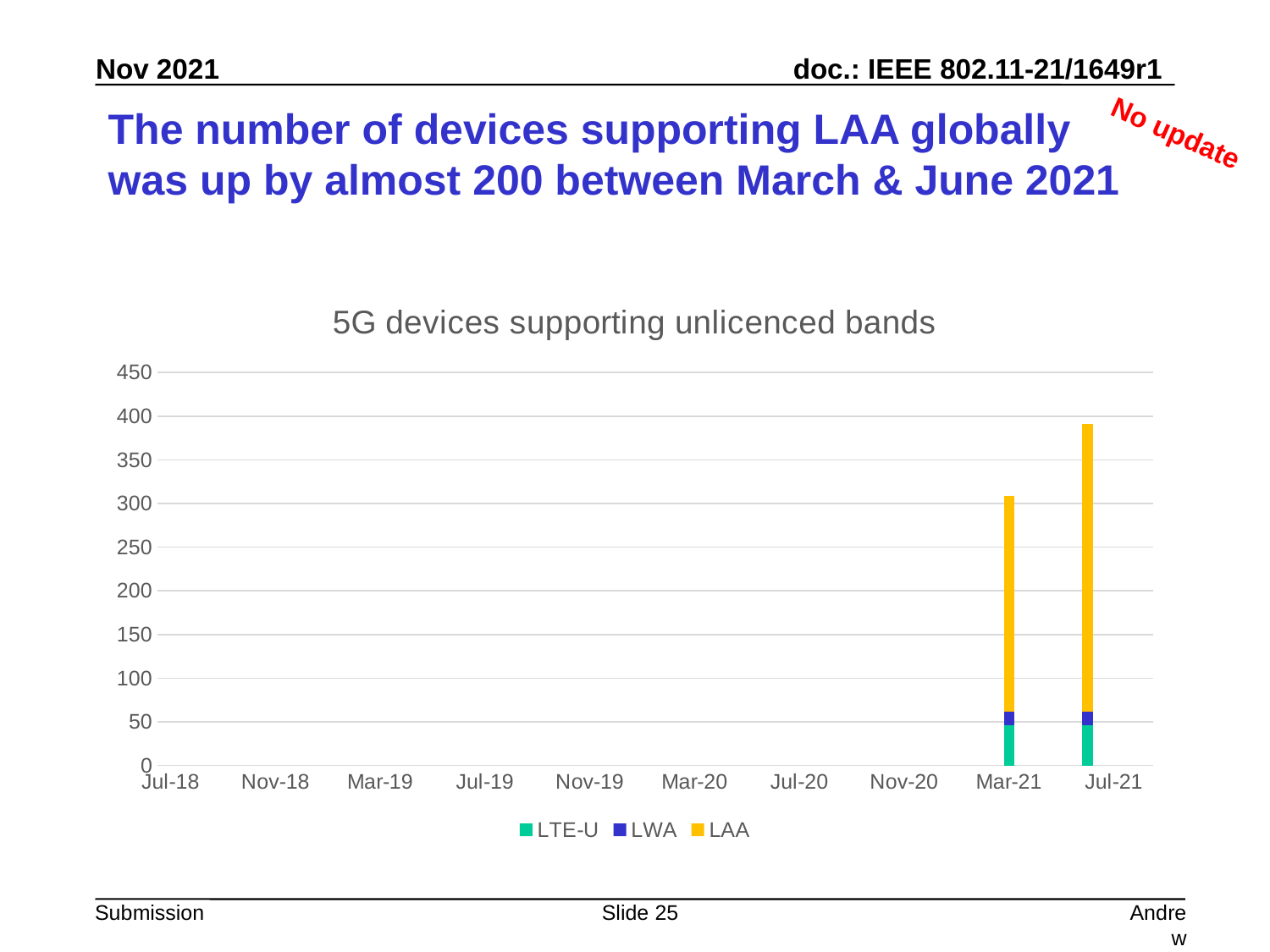
In the Jul-21 bar, which segment is larger, LAA or LTE-U? LAA How many category labels are shown along the x axis of the chart? 10 Is the total stacked value for Mar-21 greater or less than 250? greater What is the title of the chart? 5G devices supporting unlicenced bands What kind of chart is shown on the slide? bar chart Is the total stacked value for Jul-21 greater or less than 350? greater Which series is shown in yellow in the chart? LAA How many series does the legend of the chart list? 3 Is the total stacked value for Jul-21 greater or less than 400? less Which x-axis category has the tallest stacked bar? Jul-21 Which has the taller stacked bar, Mar-21 or Jul-21? Jul-21